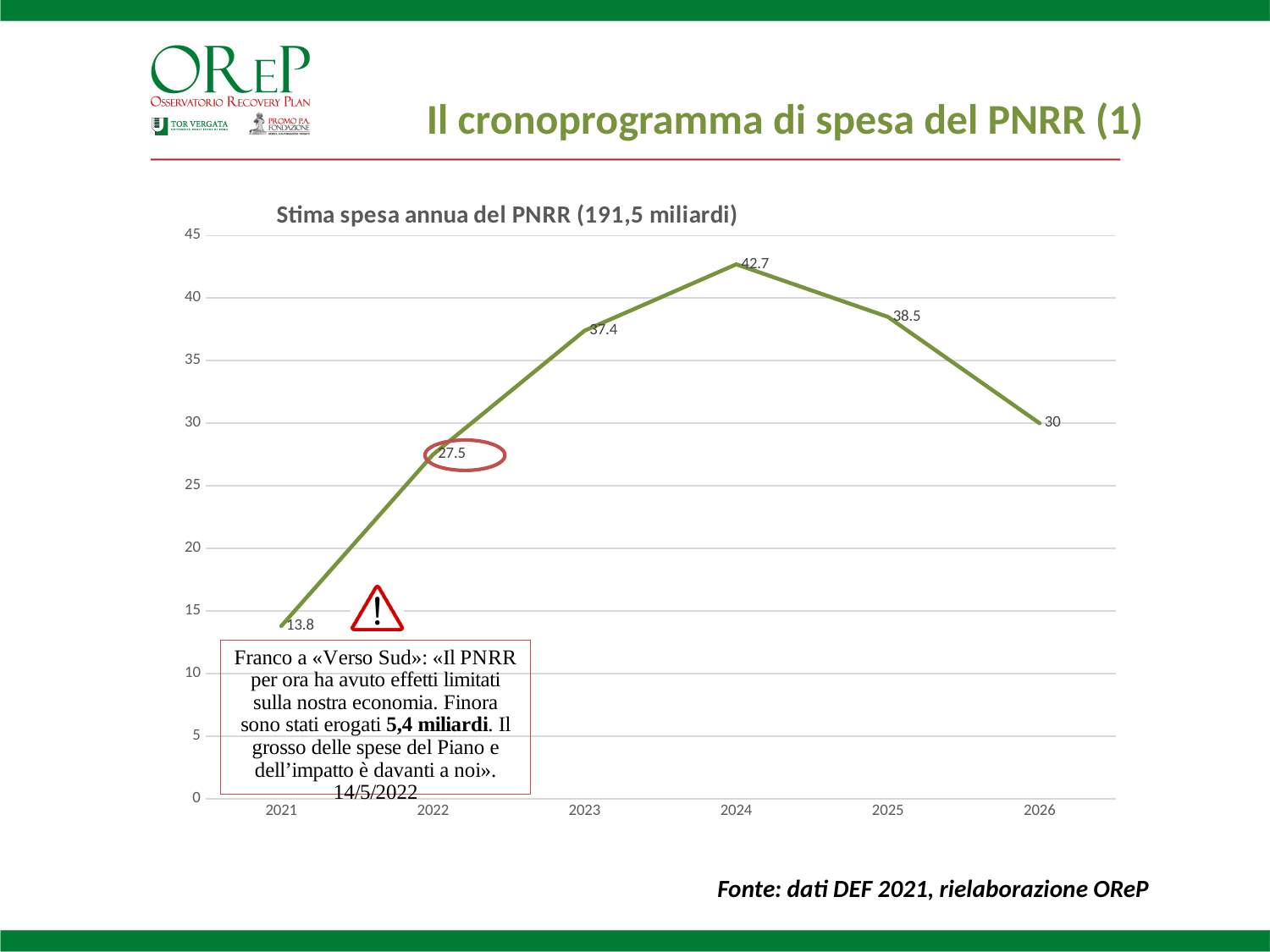
Which is larger, the value for 2023 or the value for 2025? 2025 What is the title of the chart? Stima spesa annua del PNRR (191,5 miliardi) What is the value shown for 2026? 30 What is the value shown for 2021? 13.8 Which year has the lowest estimated annual spending? 2021 What is the estimated annual PNRR spending for 2024? 42.7 What is the difference between the values for 2025 and 2026? 8.5 Is the value for 2022 greater or less than 25? greater What kind of chart is shown on the slide? line chart What is the difference between the values for 2024 and 2021? 28.9 How many years are plotted on the chart? 6 Which year has the highest estimated annual spending? 2024